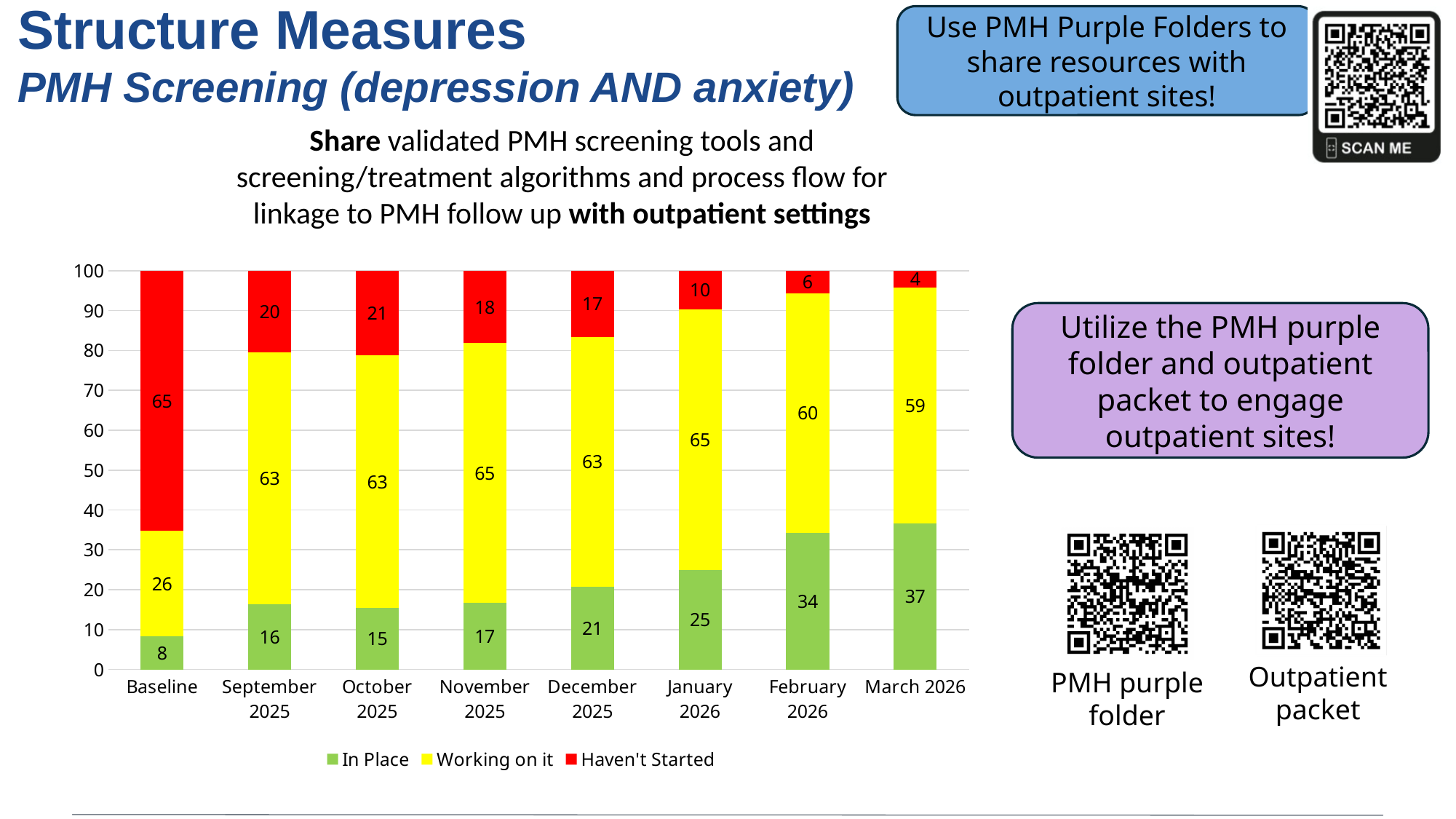
What is the 'Working on it' value for February 2026? 60 What is the 'In Place' value for Baseline? 8 What type of chart is shown on the slide? Stacked bar chart How many series does the chart legend list? 3 What is the 'Haven't Started' value for October 2025? 21 Which category has the highest 'In Place' value? March 2026 How many categories are shown along the x axis of the chart? 8 What is the difference between the 'In Place' values for March 2026 and Baseline? 29 Does the 'In Place' value rise or fall from Baseline to March 2026? Rise Which category has the lowest 'Haven't Started' value? March 2026 What is the total of the stacked bar for November 2025? 100 Which is larger, the 'Haven't Started' value for Baseline or for January 2026? Baseline